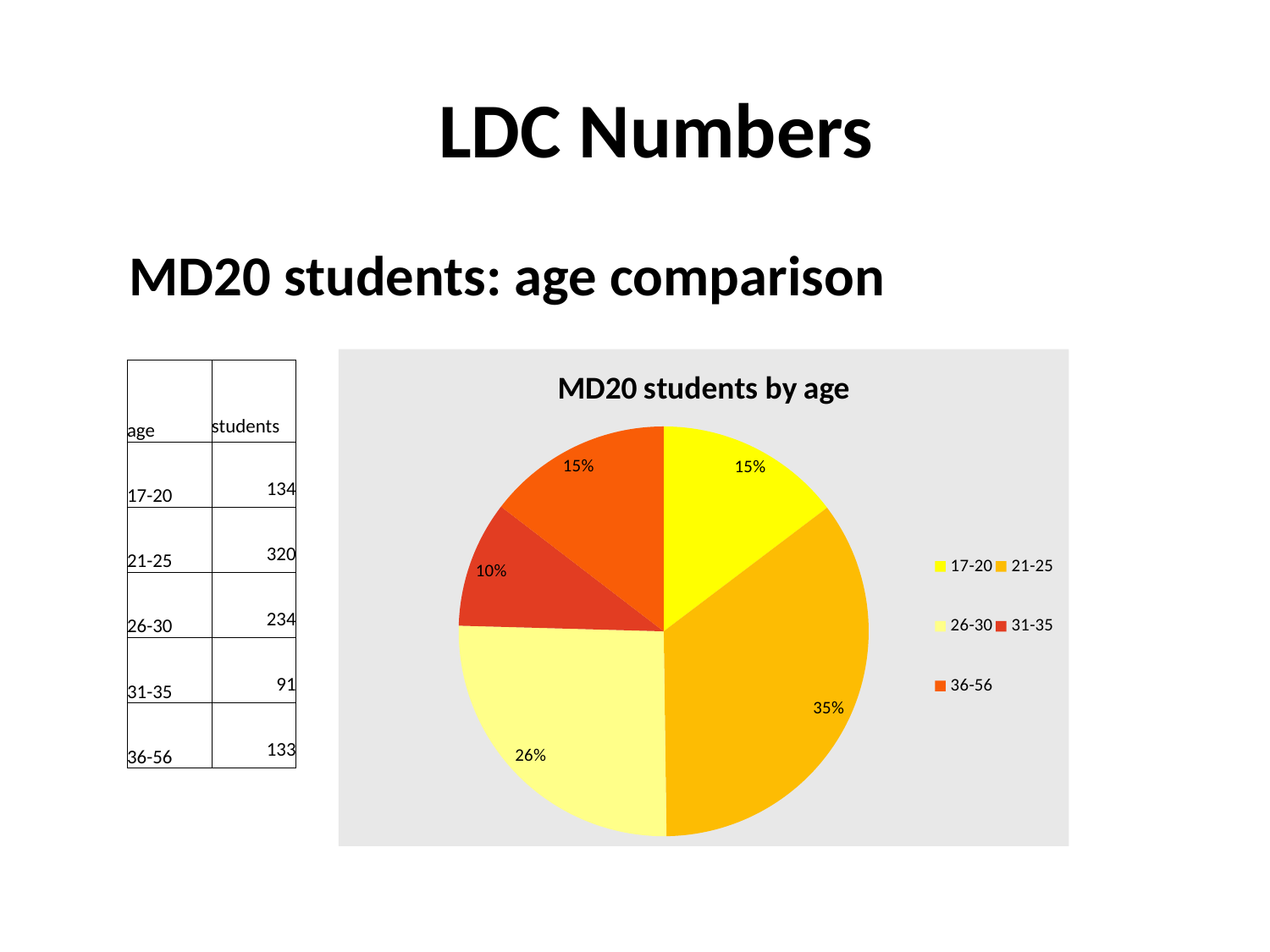
What is the difference in percentage points between the 21-25 slice and the 26-30 slice? 9 What share of the pie does the 31-35 age group represent? 10% What share of the pie does the 17-20 age group represent? 15% Which age group is shown in the lightest yellow colour? 26-30 Which age group has the largest slice of the pie? 21-25 How many age categories does the legend list? 5 Which age group has the smallest slice of the pie? 31-35 What share of the pie does the 26-30 age group represent? 26% Which slice is larger, 26-30 or 36-56? 26-30 What type of chart is shown on the slide? pie chart What is the title of the chart? MD20 students by age